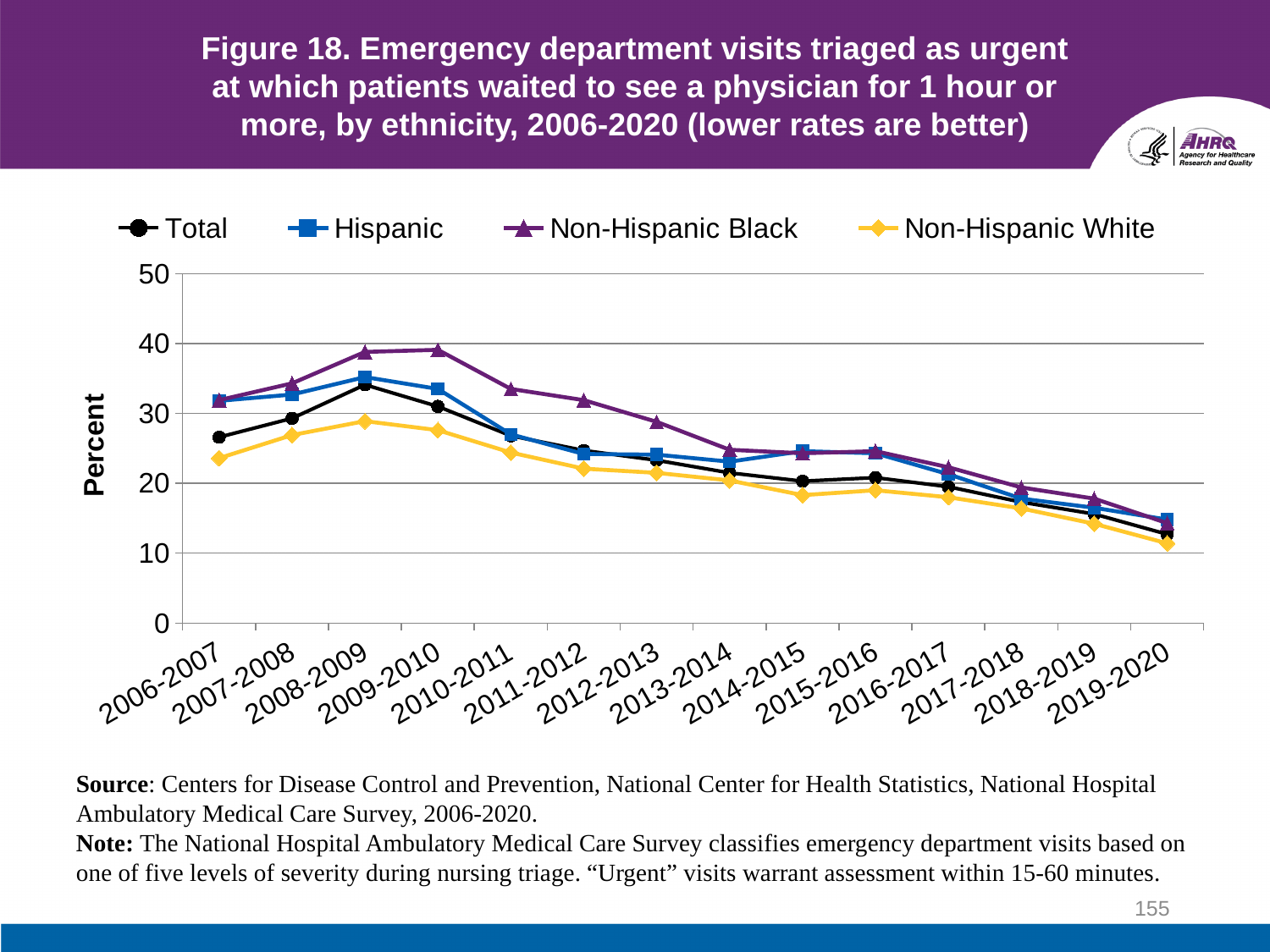
What kind of chart is shown on the slide? Line chart Is the value for Non-Hispanic Black in 2009-2010 greater or less than 30? greater Which series has the highest value in 2009-2010? Non-Hispanic Black In 2008-2009, which is larger, the value for Hispanic or the value for Non-Hispanic White? Hispanic How many time periods are shown on the x axis? 14 How many series does the legend list? 4 Which series has the lowest value in 2006-2007? Non-Hispanic White What is the label on the y axis? Percent Does the Non-Hispanic Black series rise or fall from 2009-2010 to 2019-2020? Fall In which period does the Total series reach its highest value? 2008-2009 Is the value for Total in 2006-2007 greater or less than 20? greater Is the value for Non-Hispanic White in 2019-2020 greater or less than 20? less